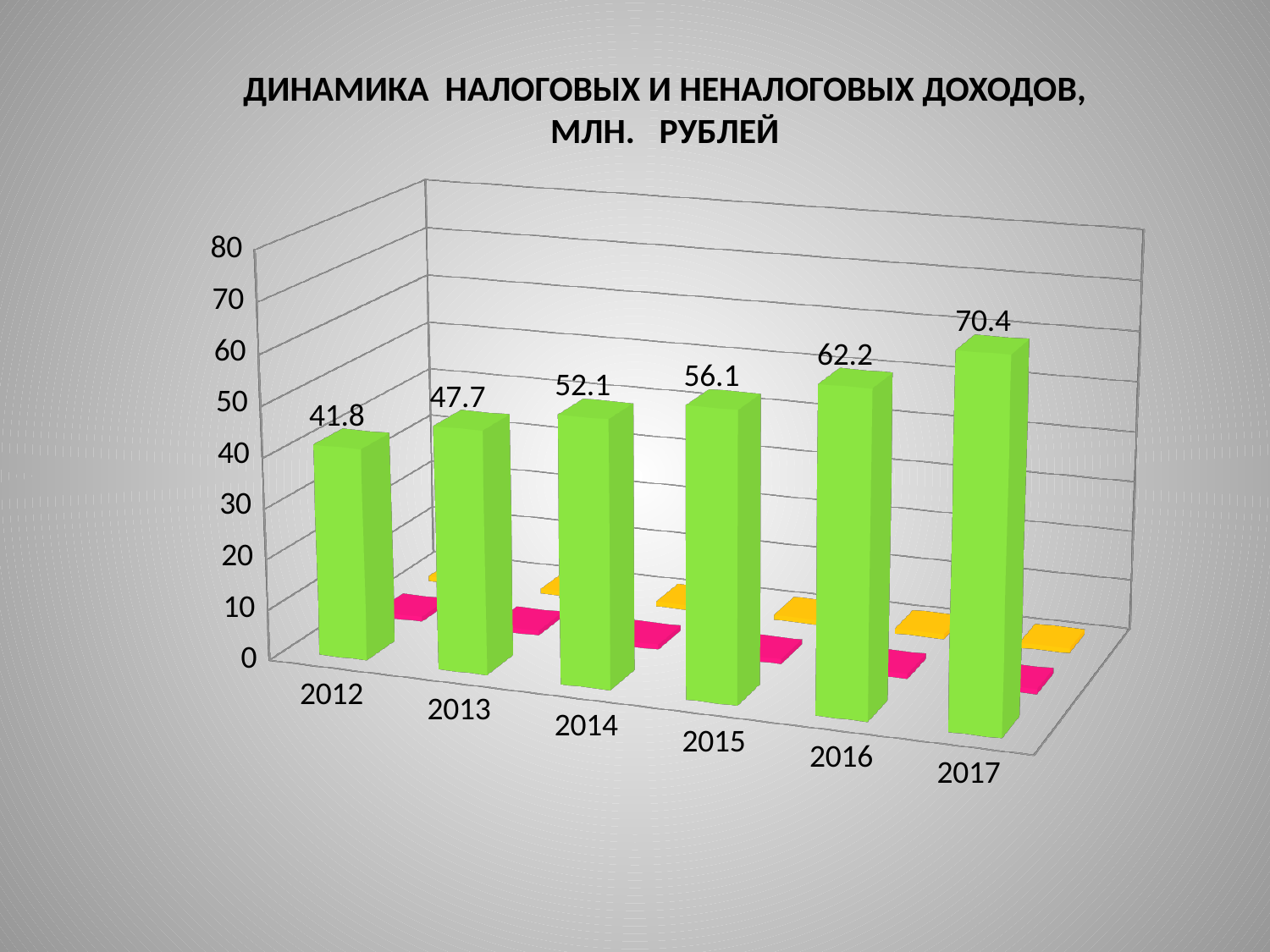
Which year has the lowest green bar? 2012 Which year has the highest green bar? 2017 Do the green bar values rise or fall from 2012 to 2017? rise Is the value of the green bar for 2016 greater or less than 60? greater What is the difference between the green bar values for 2017 and 2012? 28.6 What kind of chart is shown on the slide? bar chart Which is larger, the green bar for 2014 or the green bar for 2013? 2014 What is the value of the green bar for 2012? 41.8 What is the difference between the green bar values for 2016 and 2015? 6.1 What is the value of the green bar for 2017? 70.4 What is the value of the green bar for 2015? 56.1 How many years are shown on the x axis? 6